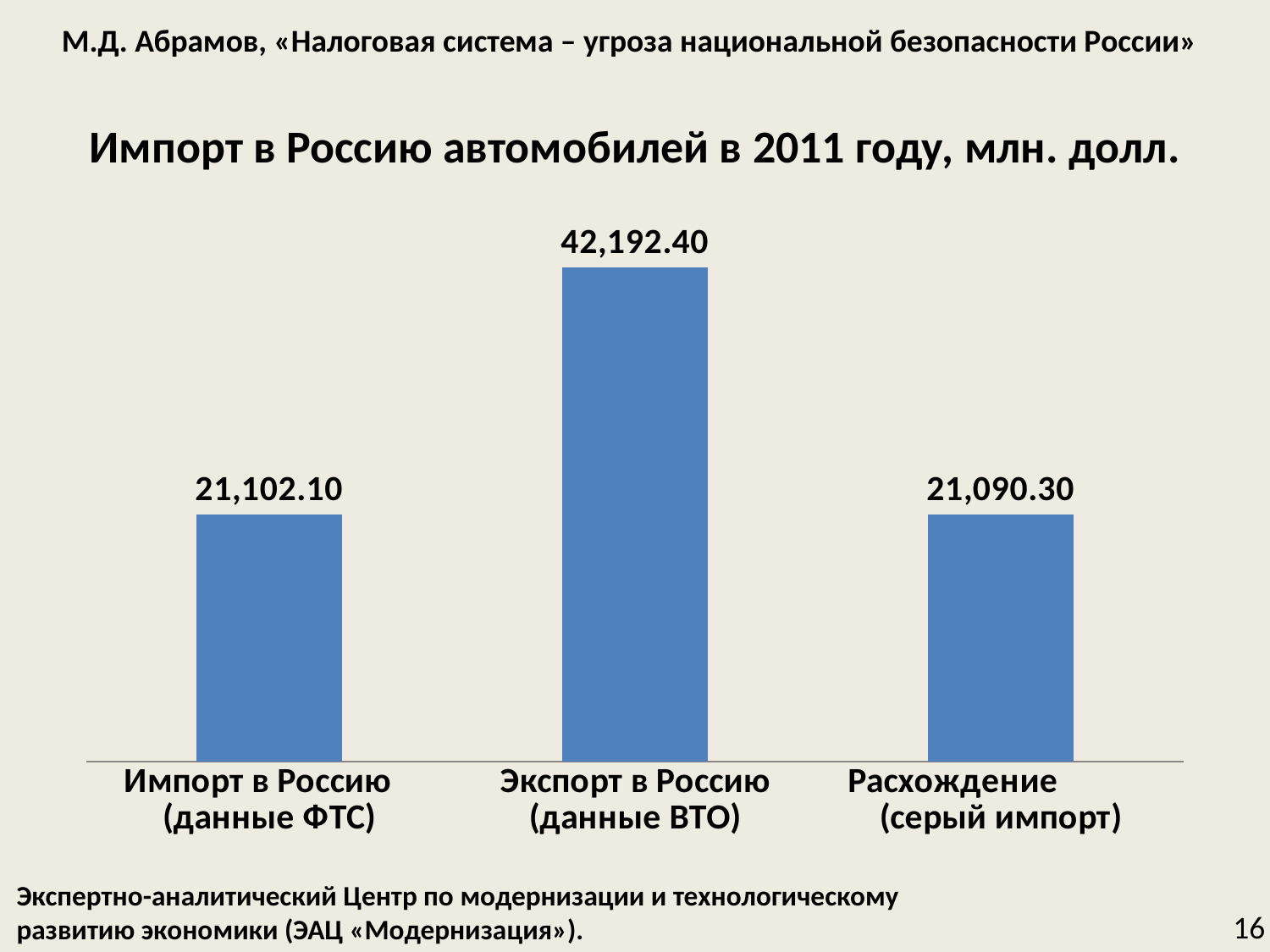
What is the difference between Экспорт в Россию (данные ВТО) and Расхождение (серый импорт)? 21,102.10 What is the value for Расхождение (серый импорт)? 21,090.30 What is the title of the chart? Импорт в Россию автомобилей в 2011 году, млн. долл. Which is larger: Экспорт в Россию (данные ВТО) or Импорт в Россию (данные ФТС)? Экспорт в Россию (данные ВТО) What type of chart is shown on the slide? Bar chart What is the value for Импорт в Россию (данные ФТС)? 21,102.10 What colour are the bars in the chart? Blue What is the difference between Импорт в Россию (данные ФТС) and Расхождение (серый импорт)? 11.80 What is the difference between Экспорт в Россию (данные ВТО) and Импорт в Россию (данные ФТС)? 21,090.30 How many bars (categories) does the chart show? 3 What is the value for Экспорт в Россию (данные ВТО)? 42,192.40 Which category has the highest value? Экспорт в Россию (данные ВТО)